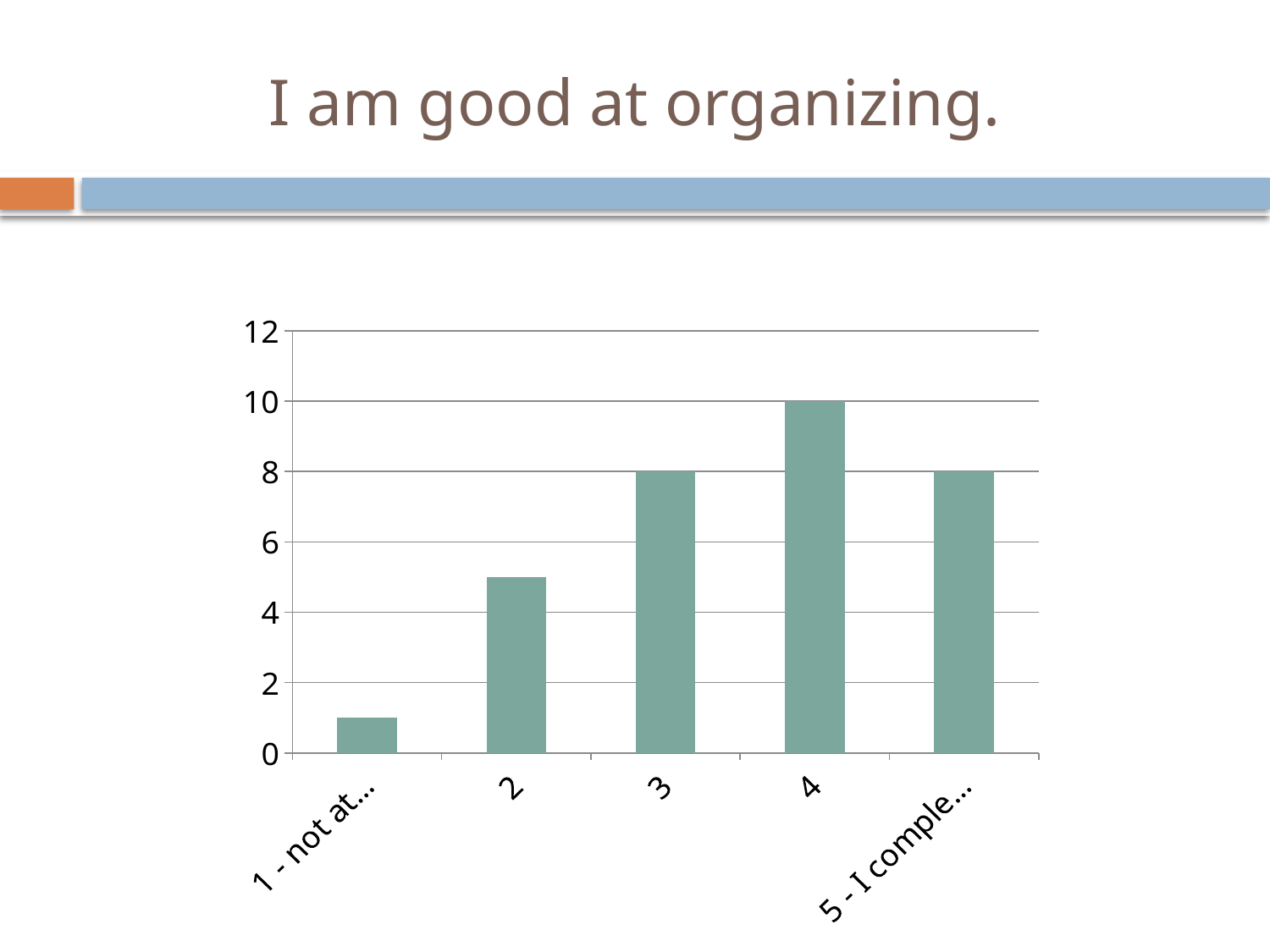
What is the value for category 3? 8 Which category has the lowest bar? 1 - not at... Is the value for category 2 greater or less than 4? greater What is the title of the slide? I am good at organizing. What is the difference between the values for category 4 and category 3? 2 How many categories are shown on the x axis of the chart? 5 What is the value for the category labelled "5 - I comple..."? 8 What is the value for category 4? 10 Which has the larger value, category 2 or category 3? 3 What type of chart is shown on the slide? bar chart Which category has the highest bar? 4 Is the value for the category labelled "1 - not at..." greater or less than 2? less